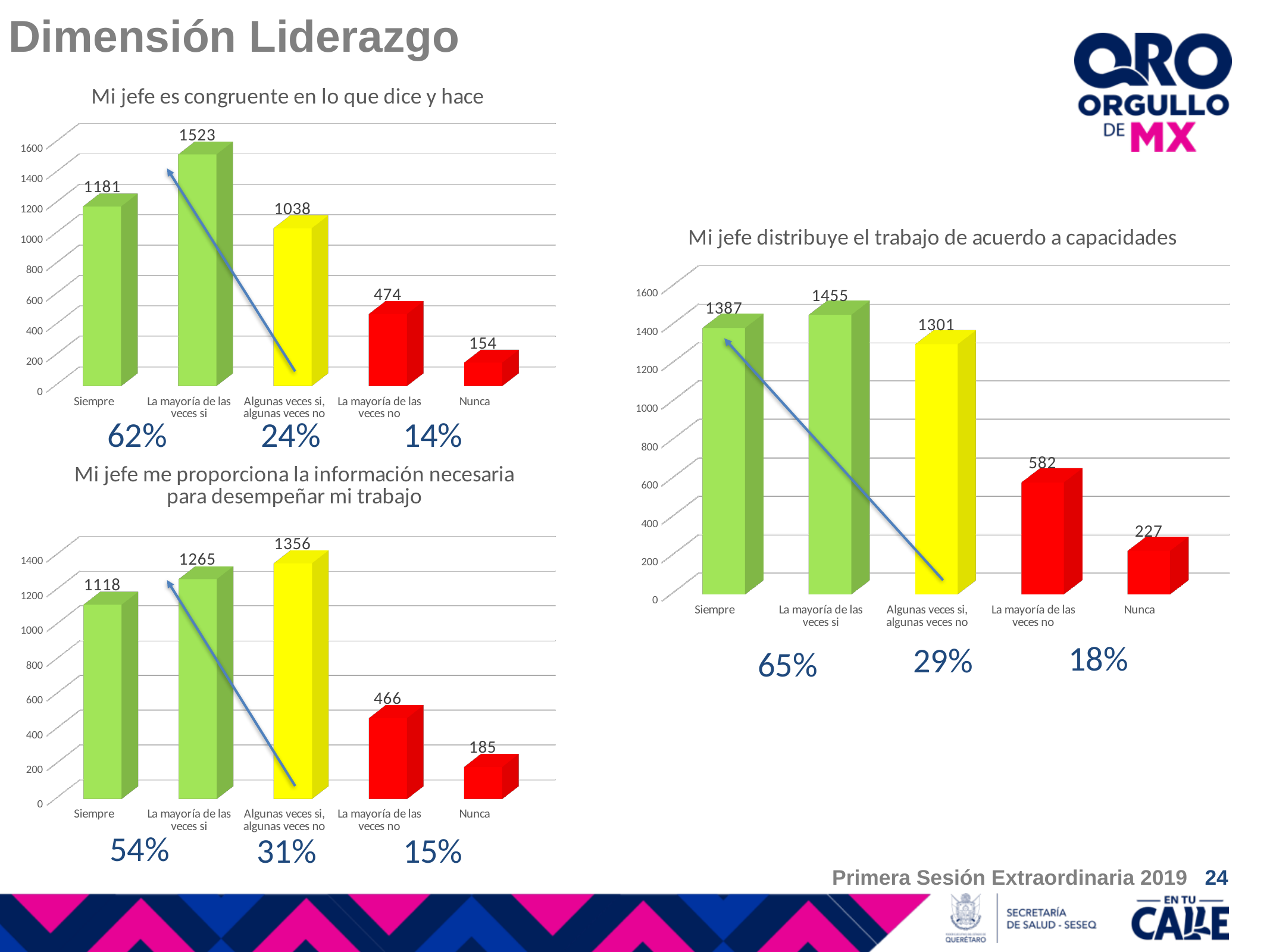
In the chart 'Mi jefe es congruente en lo que dice y hace', what colour are the bars for 'La mayoría de las veces no' and 'Nunca'? Red In the chart 'Mi jefe me proporciona la información necesaria para desempeñar mi trabajo', what is the value for 'Algunas veces si, algunas veces no'? 1356 In the chart 'Mi jefe es congruente en lo que dice y hace', what is the value for 'Siempre'? 1181 In the chart 'Mi jefe distribuye el trabajo de acuerdo a capacidades', which category has the highest value? La mayoría de las veces si In the chart 'Mi jefe es congruente en lo que dice y hace', which category has the highest value? La mayoría de las veces si In the chart 'Mi jefe me proporciona la información necesaria para desempeñar mi trabajo', which is larger: 'Siempre' or 'La mayoría de las veces si'? La mayoría de las veces si How many categories are shown in the chart 'Mi jefe distribuye el trabajo de acuerdo a capacidades'? 5 What kind of chart is 'Mi jefe es congruente en lo que dice y hace'? Bar chart In the chart 'Mi jefe es congruente en lo que dice y hace', what is the difference between 'La mayoría de las veces no' and 'Nunca'? 320 In the chart 'Mi jefe distribuye el trabajo de acuerdo a capacidades', what is the value for 'La mayoría de las veces no'? 582 In the chart 'Mi jefe distribuye el trabajo de acuerdo a capacidades', what is the difference between 'Siempre' and 'Algunas veces si, algunas veces no'? 86 In the chart 'Mi jefe me proporciona la información necesaria para desempeñar mi trabajo', which category has the lowest value? Nunca